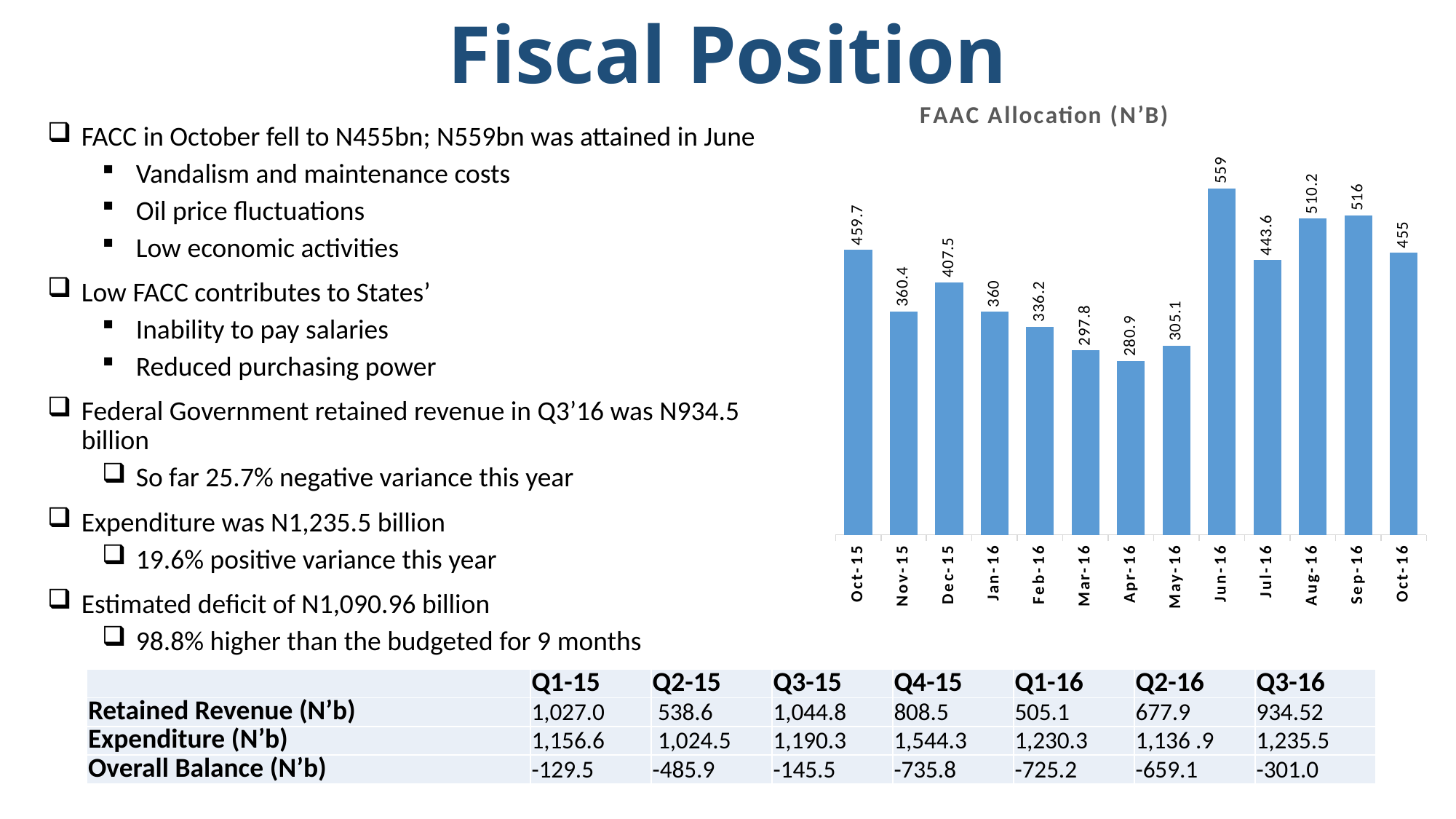
What is the FAAC allocation for Apr-16? 280.9 What is the title of the chart? FAAC Allocation (N'B) What type of chart is the FAAC Allocation chart? Bar chart Which month has the highest FAAC allocation? Jun-16 What is the difference between the FAAC allocation in Jun-16 and Oct-16? 104 What is the difference between the FAAC allocation in Aug-16 and Sep-16? 5.8 Which month has the lowest FAAC allocation? Apr-16 Which is larger, the FAAC allocation for Dec-15 or Jan-16? Dec-15 Do the FAAC allocation values rise or fall from Oct-15 to Apr-16? Fall (overall, with a rise in Dec-15) What is the FAAC allocation for Jun-16? 559 How many months are shown in the FAAC Allocation chart? 13 What is the FAAC allocation for Oct-15? 459.7